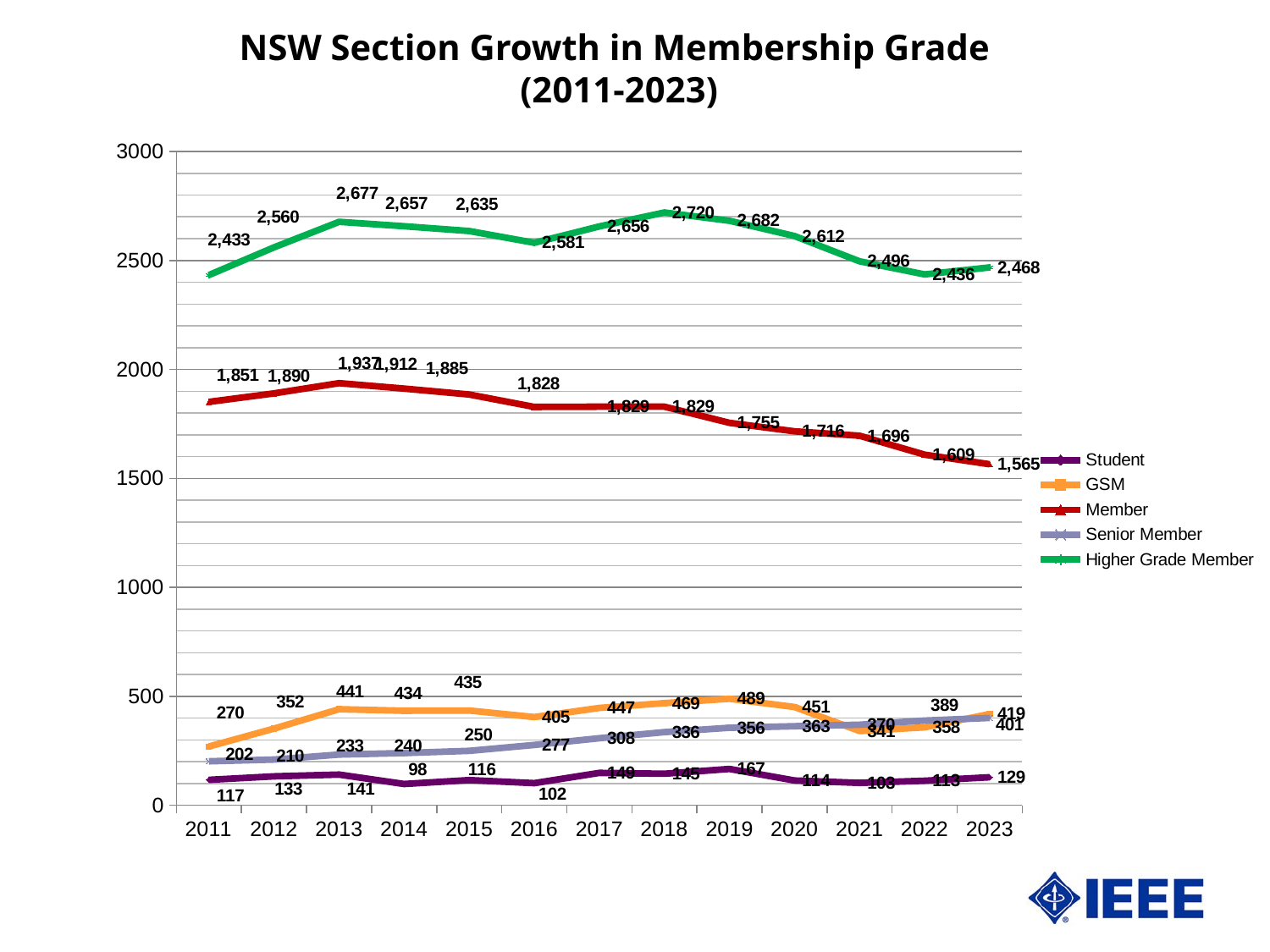
How many series does the legend list? 5 How many years are plotted along the x axis? 13 What is the difference between the Member value in 2011 and in 2023? 286 What is the Member value for 2013? 1,937 What kind of chart is shown on the slide? line chart What is the Student value for 2019? 167 In which year is the Higher Grade Member value highest? 2018 In which year is the Member value lowest? 2023 Does the Member series rise or fall from 2013 to 2023? fall What is the Higher Grade Member value for 2018? 2,720 In which year is the GSM value highest? 2019 In 2023, which is larger: GSM or Senior Member? GSM